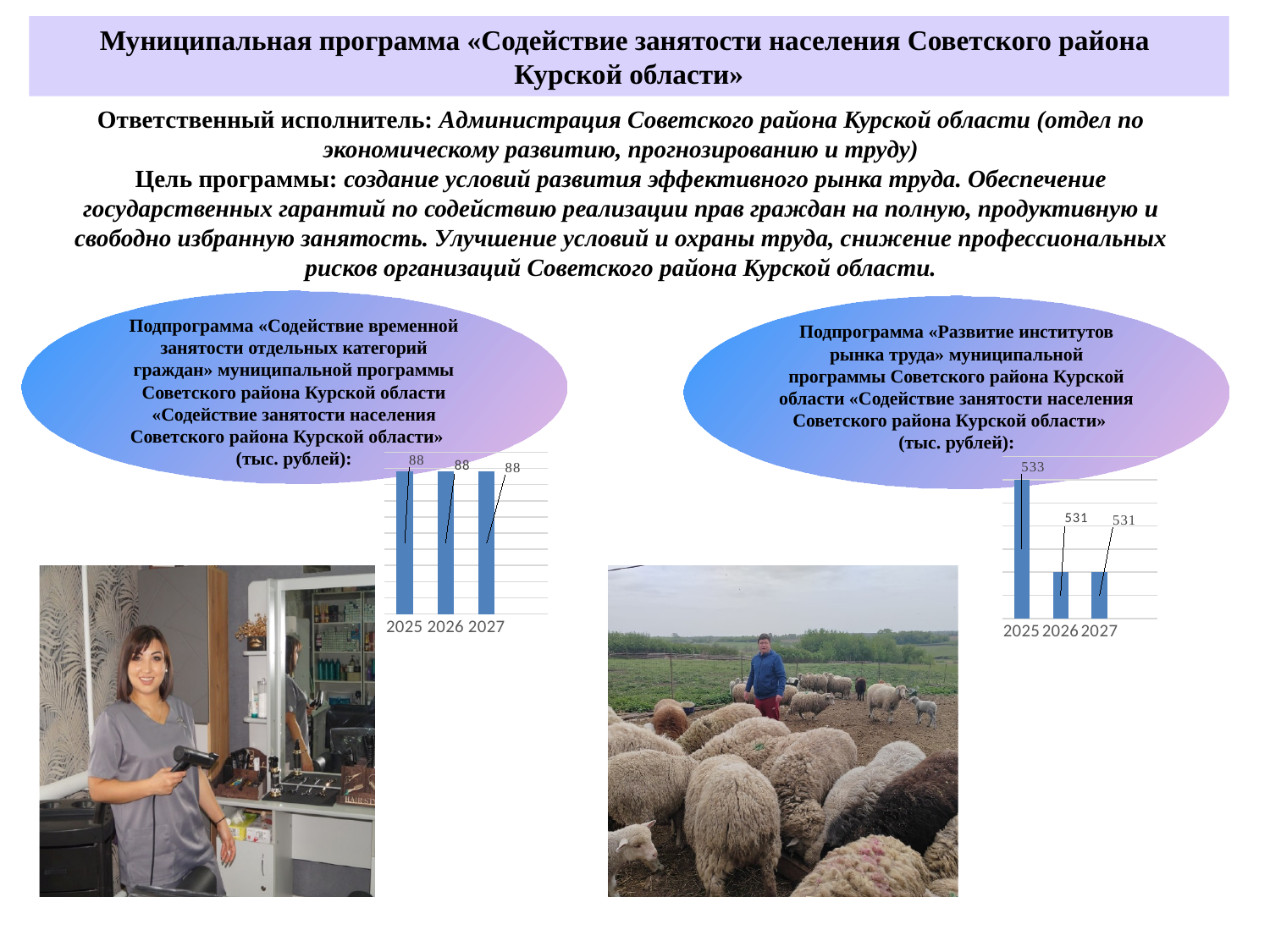
On the right chart (subprogram «Развитие институтов рынка труда»), what is the value for 2026? 531 On the right chart (subprogram «Развитие институтов рынка труда»), what is the value for 2025? 533 On the right chart (subprogram «Развитие институтов рынка труда»), which is larger, the value for 2025 or the value for 2026? 2025 What kind of chart is the right chart (subprogram «Развитие институтов рынка труда»)? Bar chart On the left chart (subprogram «Содействие временной занятости отдельных категорий граждан»), what is the value for 2027? 88 On the left chart (subprogram «Содействие временной занятости отдельных категорий граждан»), what is the value for 2025? 88 On the right chart (subprogram «Развитие институтов рынка труда»), which year has the highest value? 2025 How many years are shown on the left chart (subprogram «Содействие временной занятости отдельных категорий граждан»)? 3 On the right chart (subprogram «Развитие институтов рынка труда»), what is the difference between the values for 2025 and 2027? 2 How many categories are shown on the right chart (subprogram «Развитие институтов рынка труда»)? 3 On the left chart (subprogram «Содействие временной занятости отдельных категорий граждан»), do the values rise, fall or stay the same from 2025 to 2027? Stay the same On the right chart (subprogram «Развитие институтов рынка труда»), do the values rise or fall from 2025 to 2026? Fall